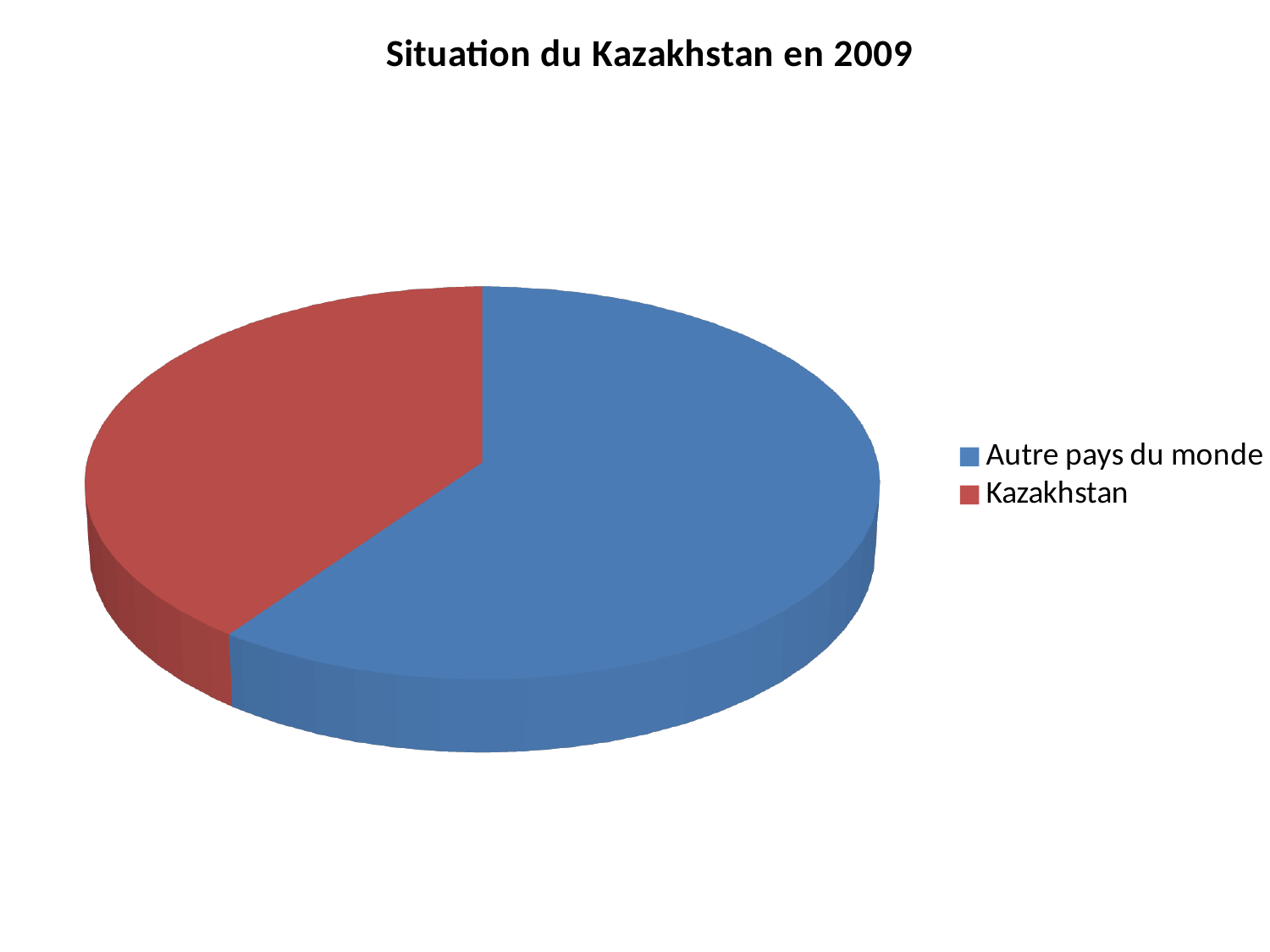
Which slice is the smallest? Kazakhstan What colour is the slice for Kazakhstan? red How many entries does the legend list? 2 Which slice is the largest? Autre pays du monde Which is larger, the slice for Kazakhstan or the slice for Autre pays du monde? Autre pays du monde What is the title of the chart? Situation du Kazakhstan en 2009 How many slices does the pie chart have? 2 What kind of chart is shown on the slide? pie chart